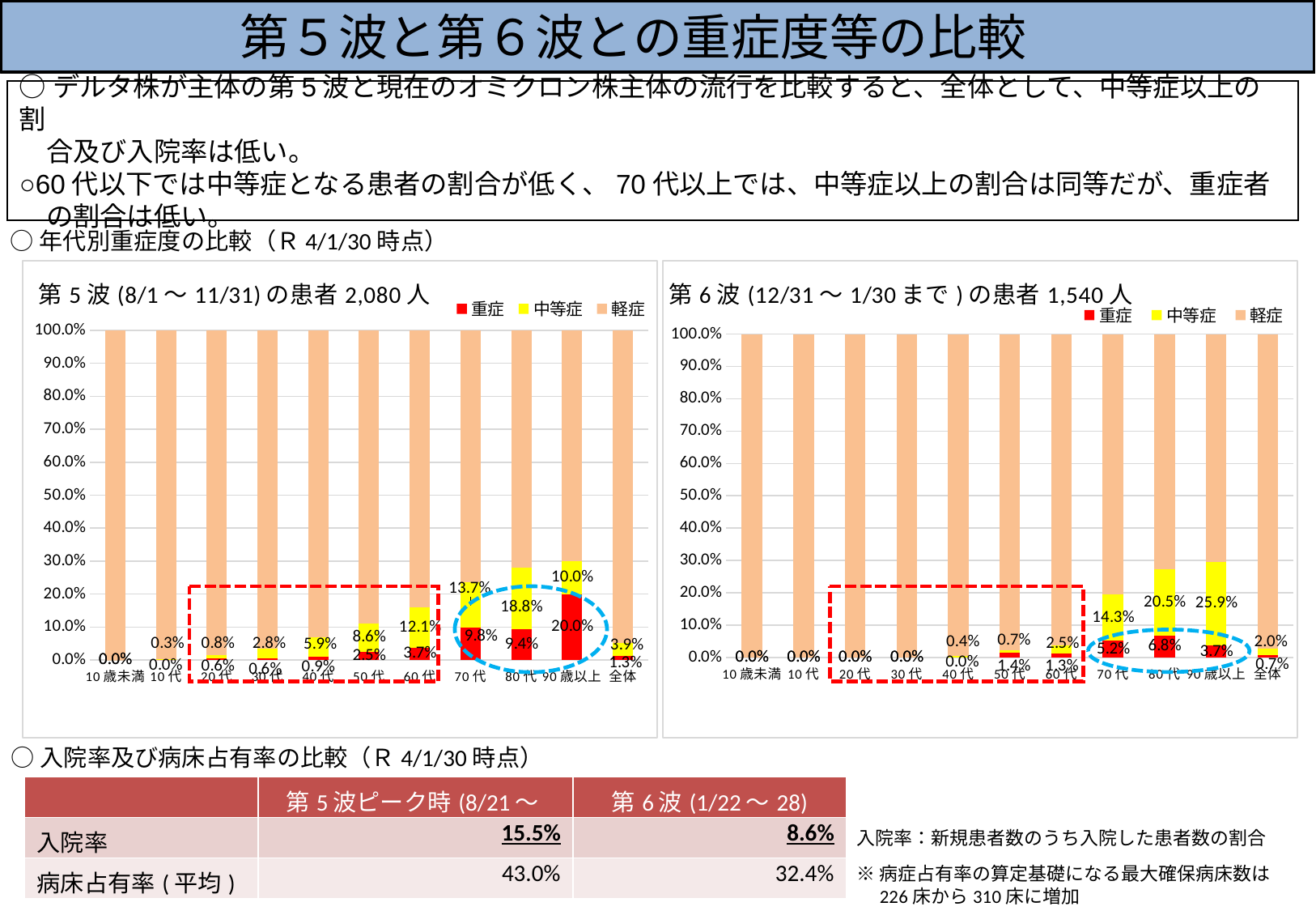
How many series does the legend of the 第6波 chart on the right list? 3 In the 第5波 chart on the left, what is the 中等症 value for 60代? 12.1% In the 第5波 chart on the left, which age group has the highest 重症 value? 90歳以上 In the 第6波 chart on the right, what is the 重症 value for 80代? 6.8% In the 第5波 chart on the left, what is the 重症 value for 90歳以上? 20.0% What kind of chart is the 第5波 chart on the left? Stacked bar chart What is the difference between the 中等症 value for 80代 in the 第6波 chart and the 中等症 value for 80代 in the 第5波 chart? 1.7% Is the 重症 value for 70代 larger in the 第5波 chart or the 第6波 chart? 第5波 In the 第6波 chart on the right, which age group has the highest 中等症 value? 90歳以上 In the 第6波 chart on the right, what is the 中等症 value for 90歳以上? 25.9% How many age categories are shown on the x axis of the 第5波 chart on the left? 11 In the 第6波 chart on the right, what is the 全体 (overall) 中等症 value? 2.0%